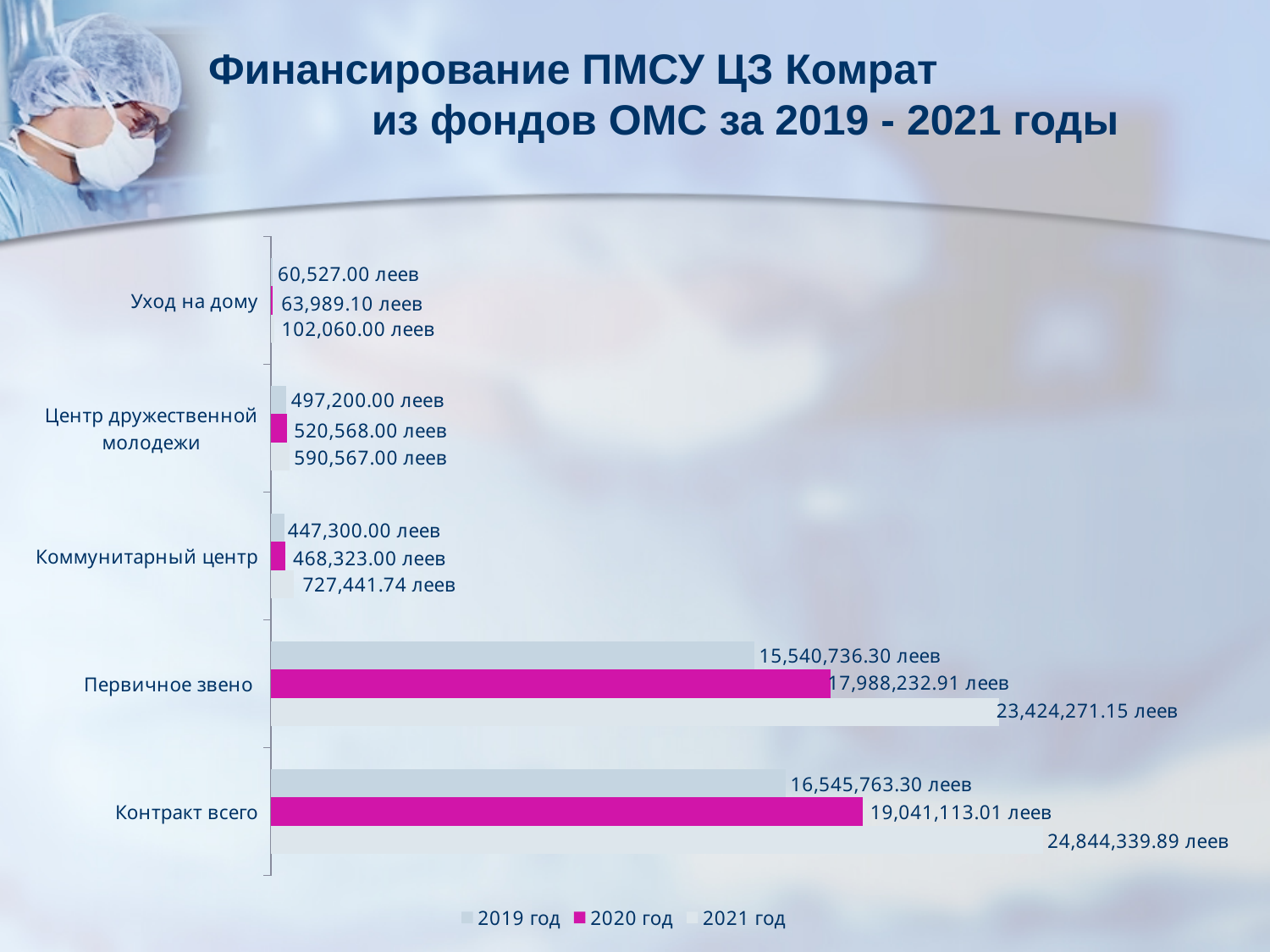
Which is larger for Центр дружественной молодежи: the 2020 год value or the 2021 год value? 2021 год Do the values for Первичное звено rise or fall from 2019 год to 2021 год? rise Which category has the highest value in 2021 год? Контракт всего What is the value for Первичное звено in 2020 год? 17,988,232.91 леев What type of chart is shown on the slide? bar chart What is the difference between the 2021 год and 2019 год values for Контракт всего? 8,298,576.59 леев How many categories are shown on the chart? 5 What is the value for Уход на дому in 2019 год? 60,527.00 леев How many series does the legend list? 3 What is the value for Контракт всего in 2021 год? 24,844,339.89 леев Which category has the lowest value in 2019 год? Уход на дому What is the value for Коммунитарный центр in 2021 год? 727,441.74 леев